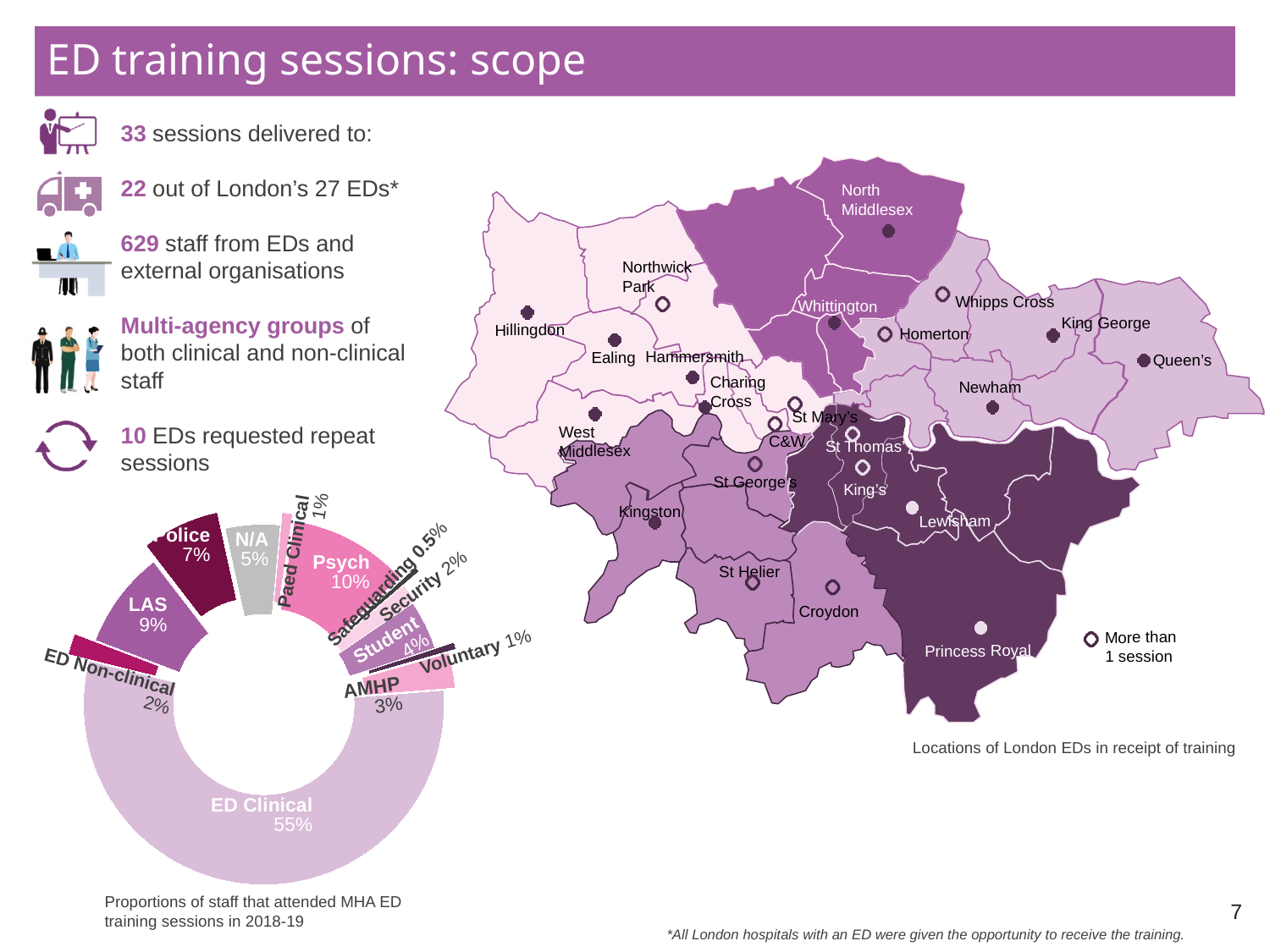
Which category has the smallest share in the donut chart? Safeguarding How many categories are shown in the donut chart? 12 Which category has the largest share in the donut chart? ED Clinical What kind of chart is the chart at the bottom left of the slide? Pie chart (donut) In the donut chart, which is larger: the share for LAS or the share for N/A? LAS In the donut chart, what percentage of staff were Safeguarding? 0.5% In the donut chart, what is the difference in percentage points between Psych and Police? 3% In the donut chart, what percentage of staff were LAS? 9% In the donut chart, what percentage of staff were AMHP? 3% In the donut chart, what percentage of staff were Psych? 10% What does the caption below the donut chart say the chart shows? Proportions of staff that attended MHA ED training sessions in 2018-19 In the donut chart, what percentage of staff were ED Clinical? 55%